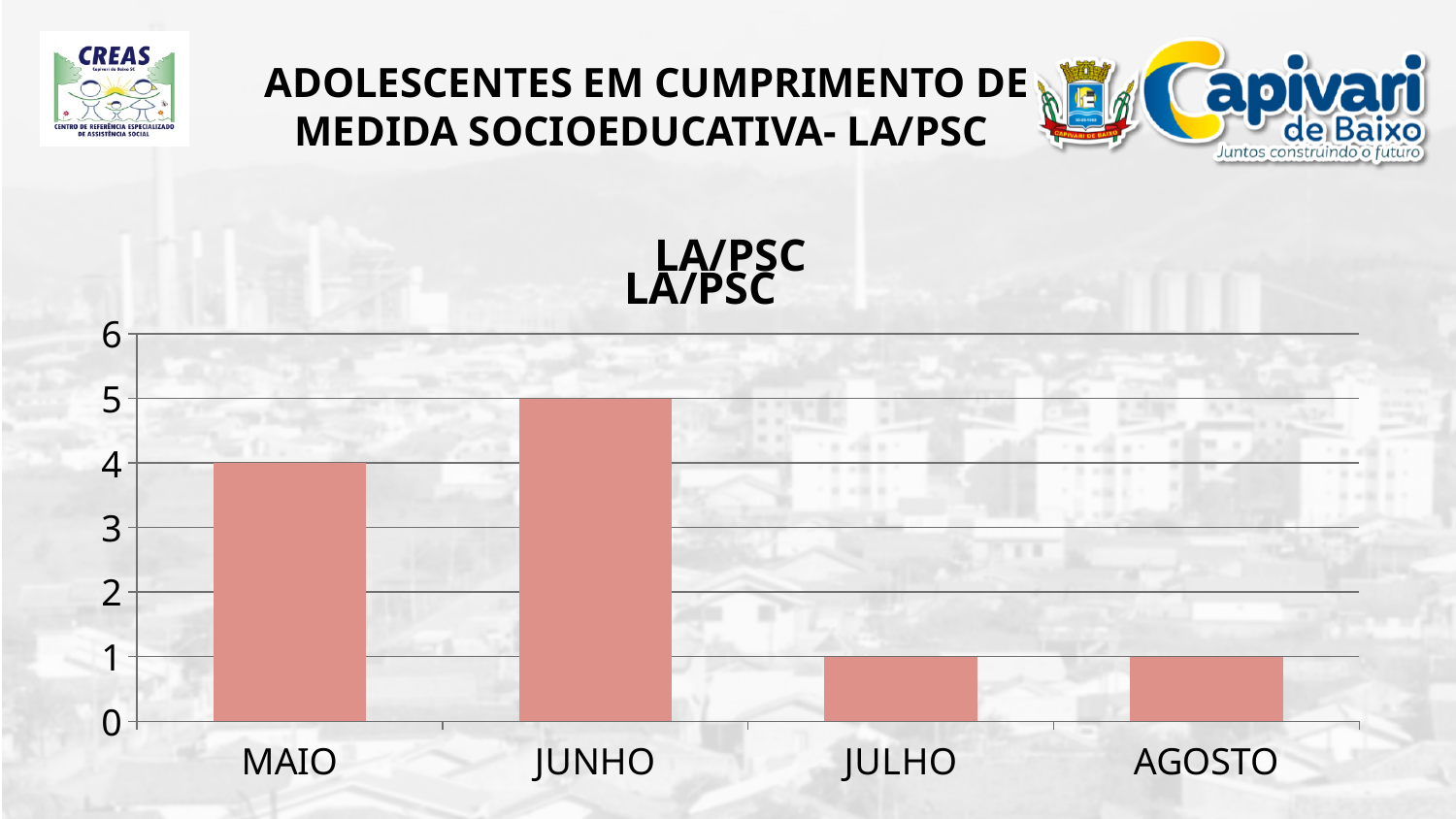
What is the value for MAIO? 4 What type of chart is shown on the slide? bar chart What is the value for JUNHO? 5 What is the title of the chart? LA/PSC How many categories are shown on the x axis of the chart? 4 Which month has the highest value? JUNHO What is the difference between the values for JUNHO and MAIO? 1 What is the value for AGOSTO? 1 What is the value for JULHO? 1 What is the difference between the values for JUNHO and JULHO? 4 Which is larger, the value for MAIO or the value for AGOSTO? MAIO Is the value for JUNHO greater or less than 3? greater